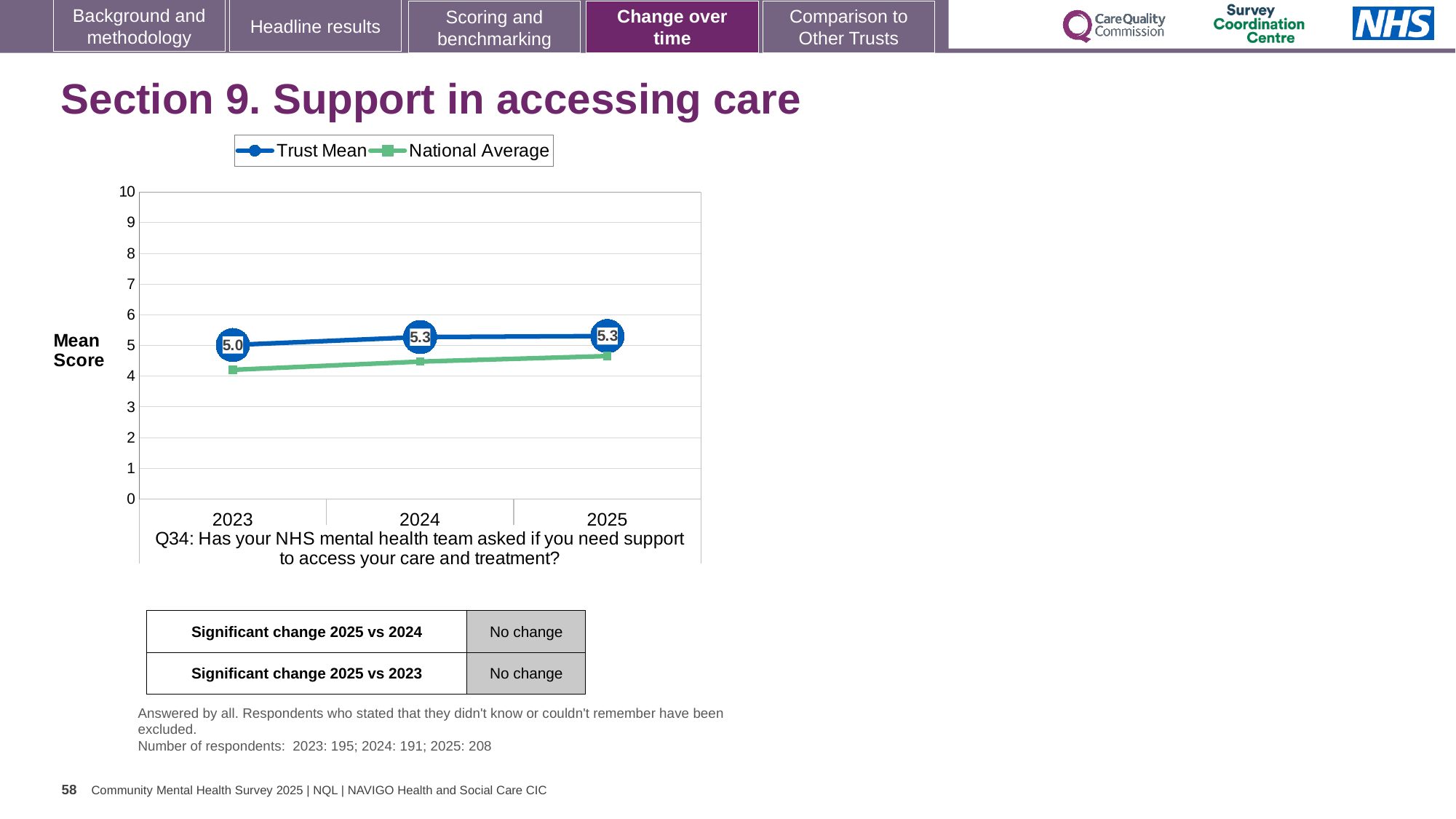
How many years are shown on the x axis of the chart? 3 What is the Trust Mean value for 2023? 5.0 What kind of chart is shown on the slide? line chart In which year is the Trust Mean lowest? 2023 How many series does the chart legend list? 2 Is the National Average value for 2025 greater or less than 5? less What is the difference between the Trust Mean in 2024 and in 2023? 0.3 What is the Trust Mean value for 2024? 5.3 Is the National Average value for 2023 greater or less than 5? less Does the National Average rise or fall from 2023 to 2025? rise What is the Trust Mean value for 2025? 5.3 In 2023, which is larger: the Trust Mean or the National Average? Trust Mean